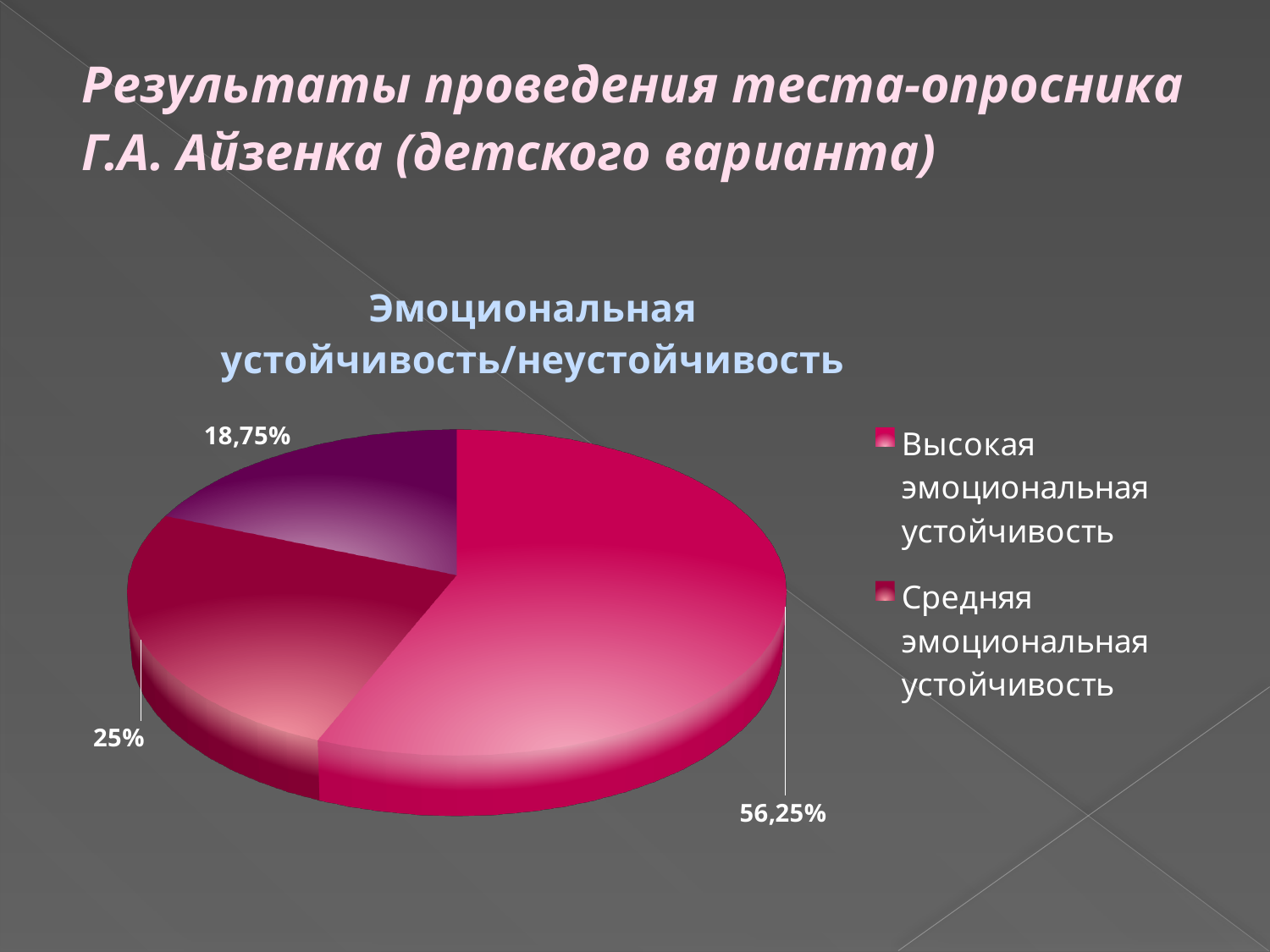
What is the difference between the Высокая эмоциональная устойчивость slice and the Средняя эмоциональная устойчивость slice? 31,25% What kind of chart is shown on the slide? Pie chart What do the three slice percentages add up to? 100% What is the value of the smallest slice of the pie? 18,75% How many slices does the pie chart have? 3 How many entries does the legend list? 2 What percentage is shown for Средняя эмоциональная устойчивость? 25% Which legend category has the largest slice of the pie? Высокая эмоциональная устойчивость What percentage is shown for Высокая эмоциональная устойчивость? 56,25% Which is larger: Высокая эмоциональная устойчивость or Средняя эмоциональная устойчивость? Высокая эмоциональная устойчивость What is the difference between the 25% slice and the smallest slice? 6,25% What is the title of the chart? Эмоциональная устойчивость/неустойчивость